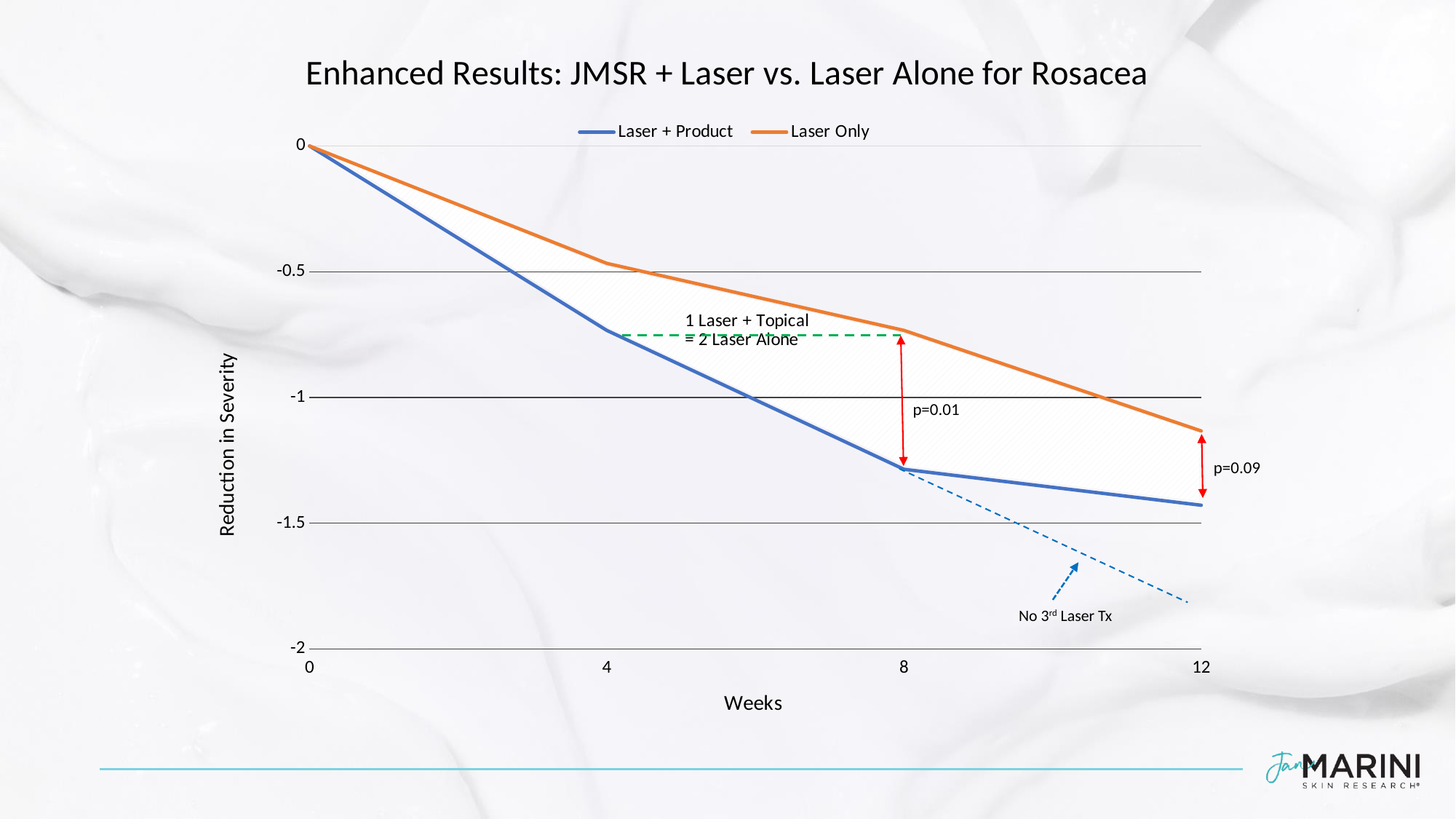
What p-value is annotated between the two series at week 8? p=0.01 How many series does the legend list? 2 At week 12, which series shows the larger reduction in severity (the lower value), Laser + Product or Laser Only? Laser + Product Is the value for Laser + Product at week 4 greater or less than -0.5? less Do the values for Laser Only rise or fall as the weeks increase? fall What kind of chart is shown on the slide? line chart Is the value for Laser + Product at week 8 greater or less than -1? less How many time points are plotted along the x axis for each series? 4 Is the value for Laser + Product at week 12 greater or less than -1.5? greater What is the value for Laser + Product at week 0? 0 What is the label of the x axis? Weeks